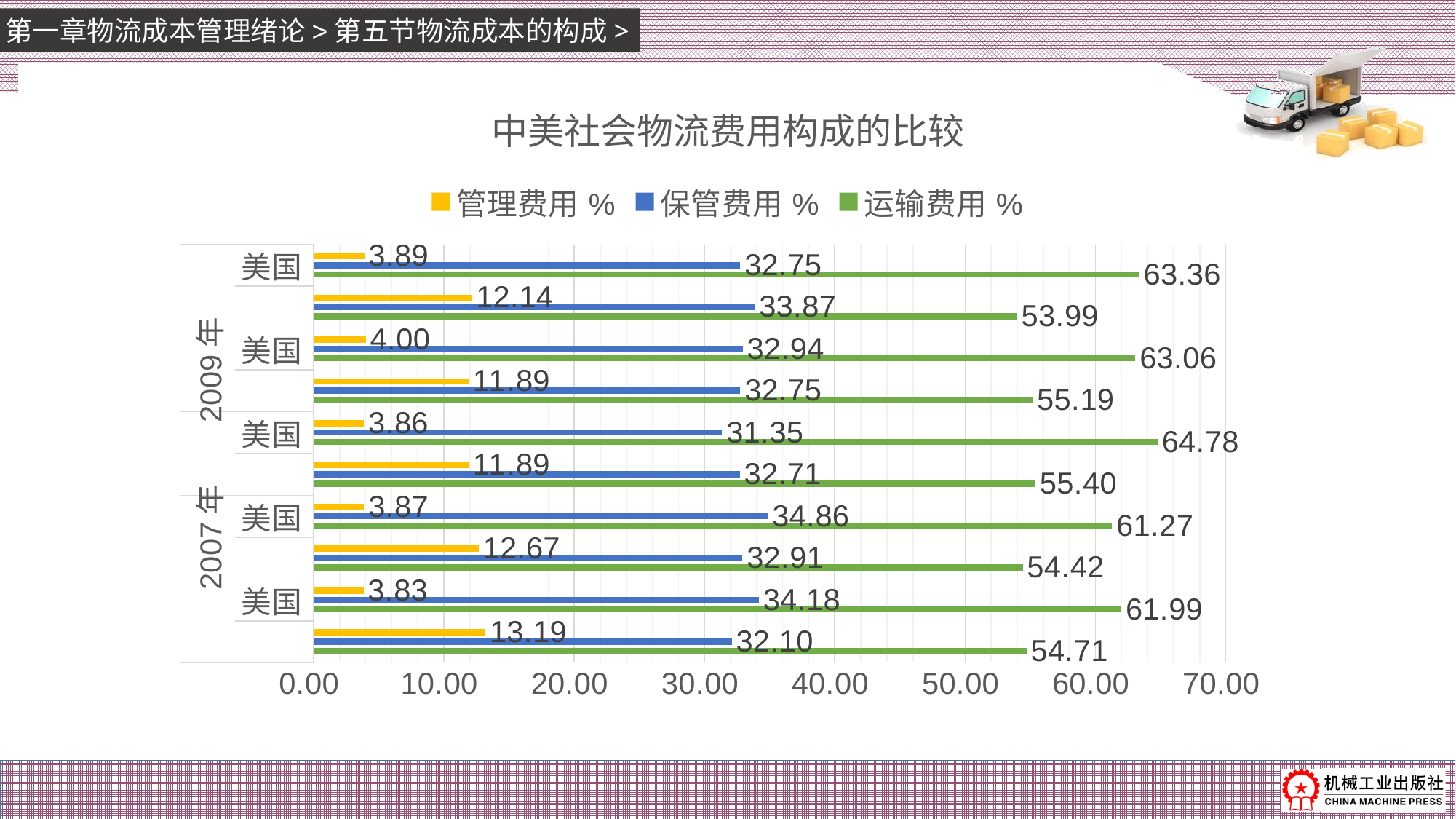
Is the 运输费用 % value in the bottom group of bars greater or less than 50.00? greater How many groups of bars are plotted on the chart? 10 What is the lowest 管理费用 % value shown on the chart? 3.83 In the topmost group of bars (labelled 美国), what is the value for 运输费用 %? 63.36 What kind of chart is shown on the slide? bar chart In the bottom group of bars, which is larger: 保管费用 % or 管理费用 %? 保管费用 % What is the highest 运输费用 % value shown on the chart? 64.78 What is the title of the chart? 中美社会物流费用构成的比较 In the topmost group of bars, what is the difference between 运输费用 % and 保管费用 %? 30.61 What is the highest 保管费用 % value shown on the chart? 34.86 How many series does the legend list? 3 In the bottom group of bars, what is the value for 管理费用 %? 13.19